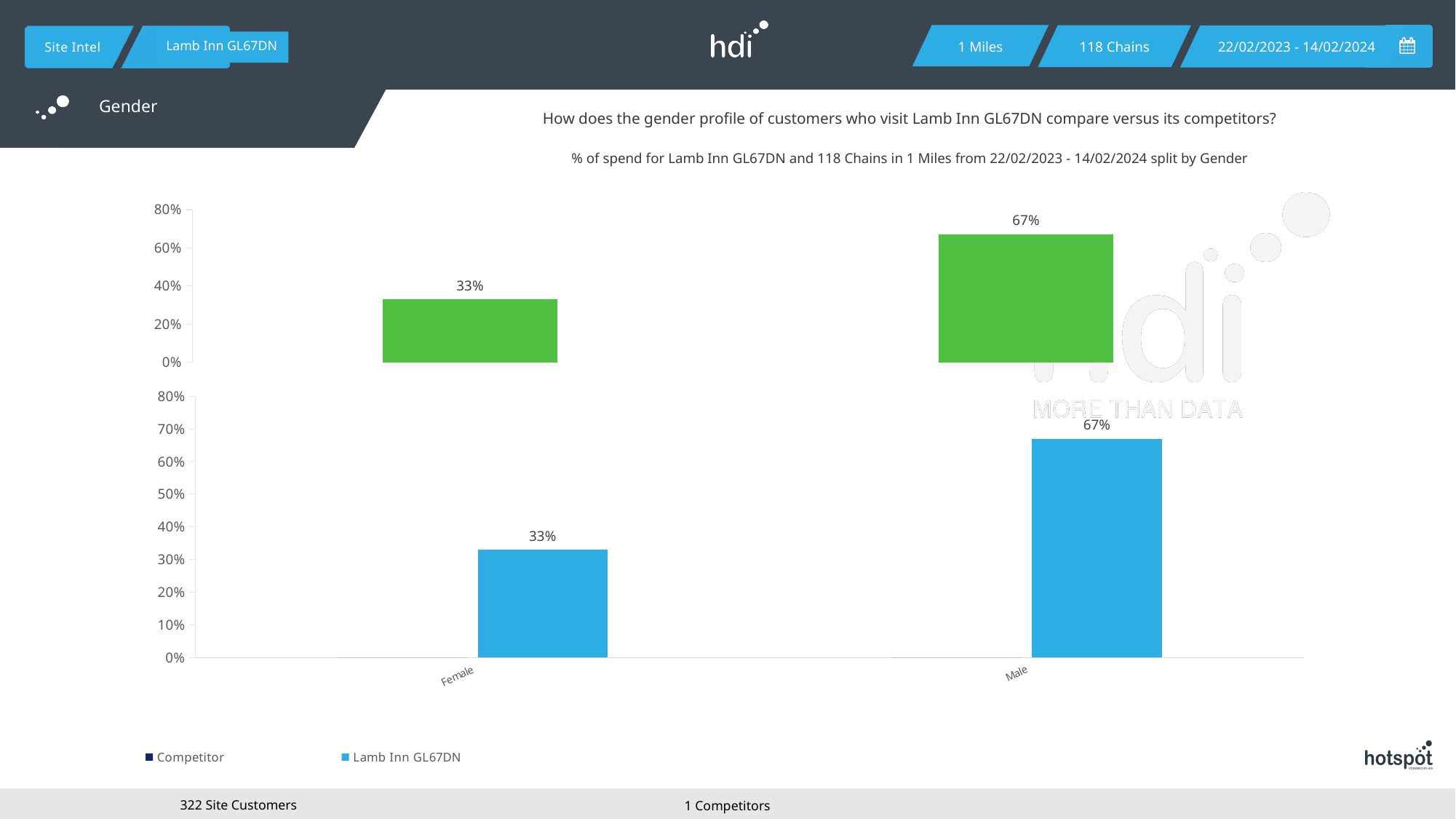
In the upper chart, is the value of the right bar greater or less than 60%? greater In the lower chart, what is the value for Male for Lamb Inn GL67DN? 67% How many categories are shown on the x axis of the lower chart? 2 In the lower chart, what is the value for Female for Lamb Inn GL67DN? 33% In the lower chart, which category has the highest value? Male In the lower chart, what is the difference between the Male and Female values? 34% In the lower chart, which category has the lowest value? Female What kind of chart is the lower chart? bar chart In the upper chart, what value is labelled on the right green bar? 67% In the lower chart, is the value for Female greater or less than 40%? less In the upper chart, what value is labelled on the left green bar? 33% How many series does the legend at the bottom of the slide list? 2